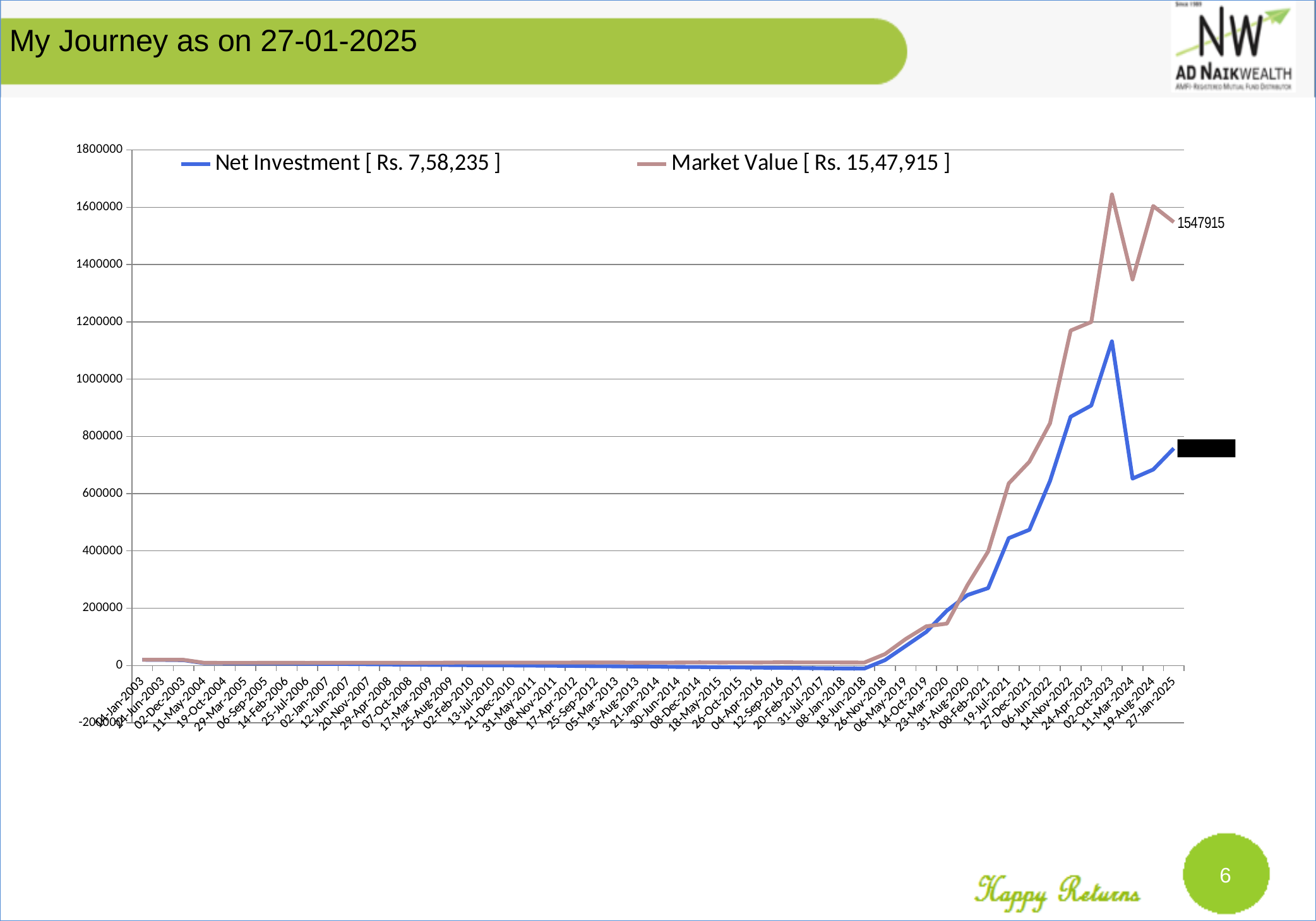
What is the Market Value on 27-Jan-2025 according to the data label? 1547915 What are the two series named in the legend? Net Investment [ Rs. 7,58,235 ] and Market Value [ Rs. 15,47,915 ] Is the Net Investment value on 02-Oct-2023 greater or less than 1000000? greater What kind of chart is shown on the slide? line chart How many series does the chart legend list? 2 Which series is drawn in blue? Net Investment Is the Market Value on 02-Oct-2023 greater or less than 1600000? greater Which series reaches the highest value on the chart? Market Value On 27-Jan-2025, which is larger: Market Value or Net Investment? Market Value Is the Net Investment value on 27-Jan-2025 greater or less than 800000? less